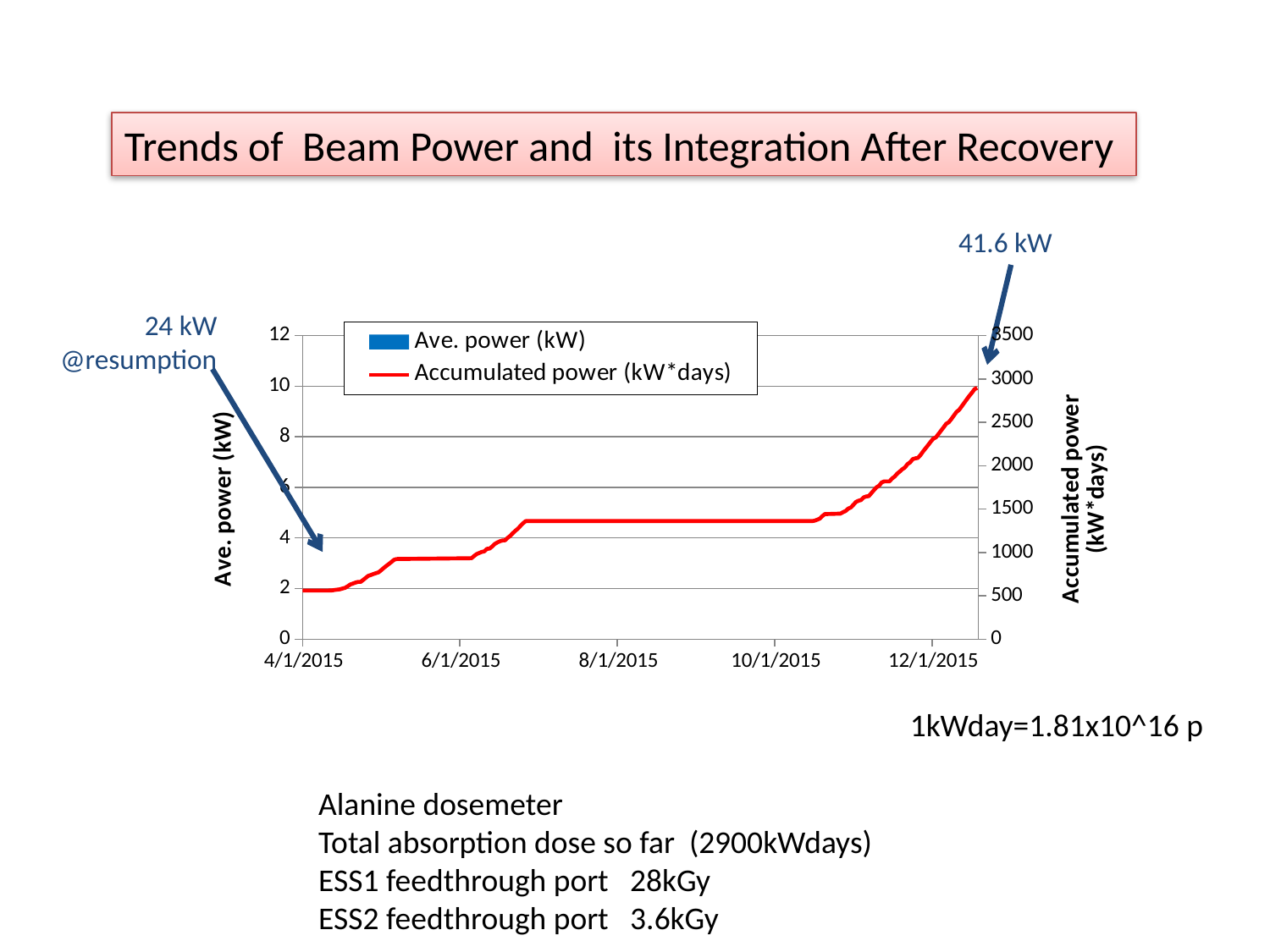
What kind of chart is used to plot the Accumulated power (kW*days) series? line chart What is the title of the chart on the slide? Trends of Beam Power and its Integration After Recovery What is the maximum value shown on the right-hand Accumulated power (kW*days) axis? 3500 What colour is the Accumulated power (kW*days) line? red Is the Accumulated power (kW*days) value at 8/1/2015 greater or less than 1500? less What beam power is annotated at the end of the plotted period on the chart? 41.6 kW What beam power is annotated at resumption on the chart? 24 kW How many series does the chart legend list? 2 Is the Accumulated power (kW*days) value at the end of the plotted period greater or less than 2500? greater Does the Accumulated power (kW*days) line rise or fall from 4/1/2015 to 12/1/2015? rise Is the Accumulated power (kW*days) value at 6/1/2015 greater or less than 500? greater According to the text below the chart, what is the total absorption dose so far? 2900kWdays